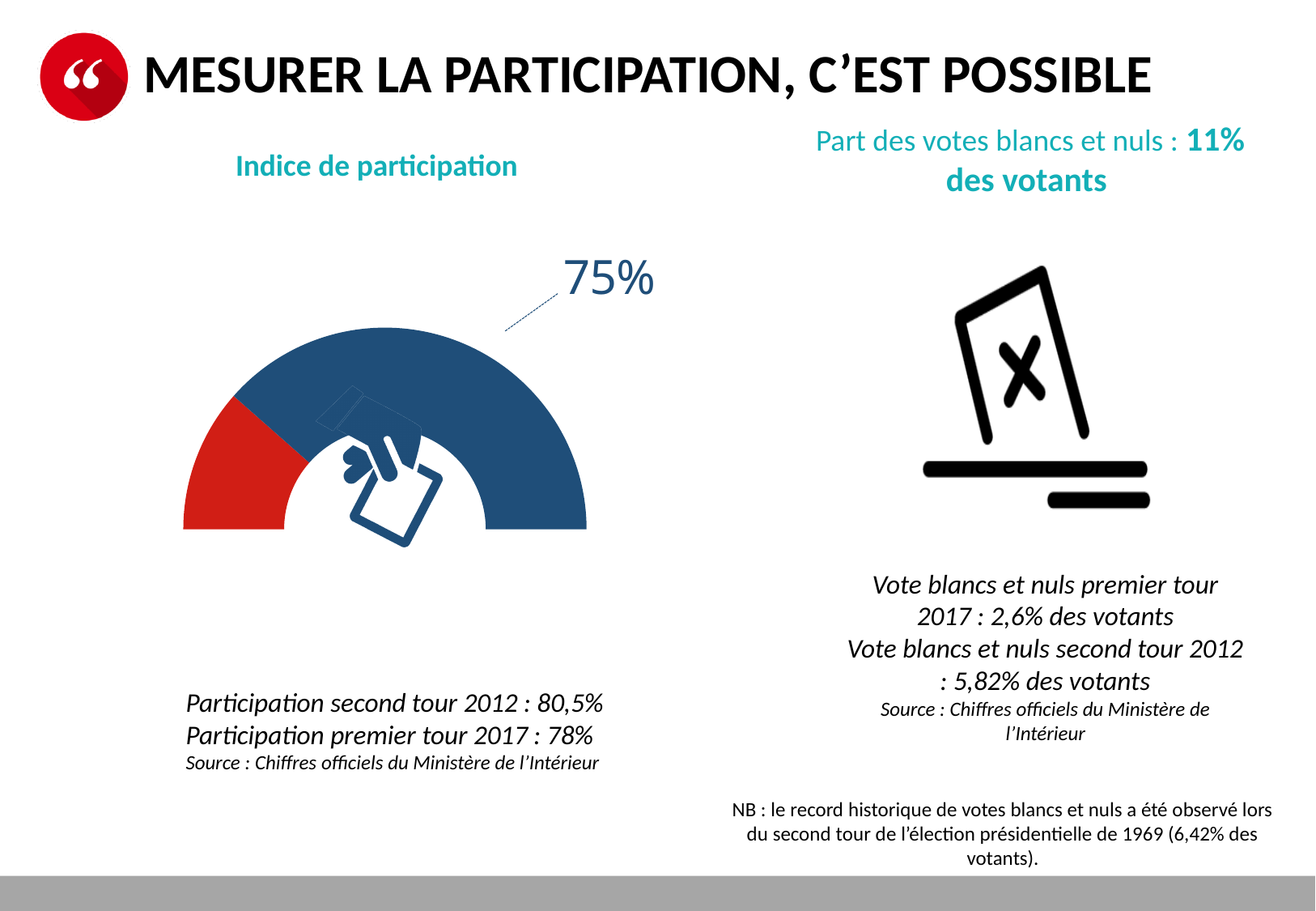
What kind of chart is the 'Indice de participation' chart? doughnut (semi-circle gauge) chart In the 'Indice de participation' chart, which segment is larger, the blue one or the red one? the blue one What colour is the segment labelled 75% in the 'Indice de participation' chart? blue What is the title of the gauge chart on the left of the slide? Indice de participation What value is printed as the data label on the 'Indice de participation' chart? 75% How many segments does the 'Indice de participation' gauge chart have? 2 Is the value labelled on the 'Indice de participation' chart greater or less than 50%? greater